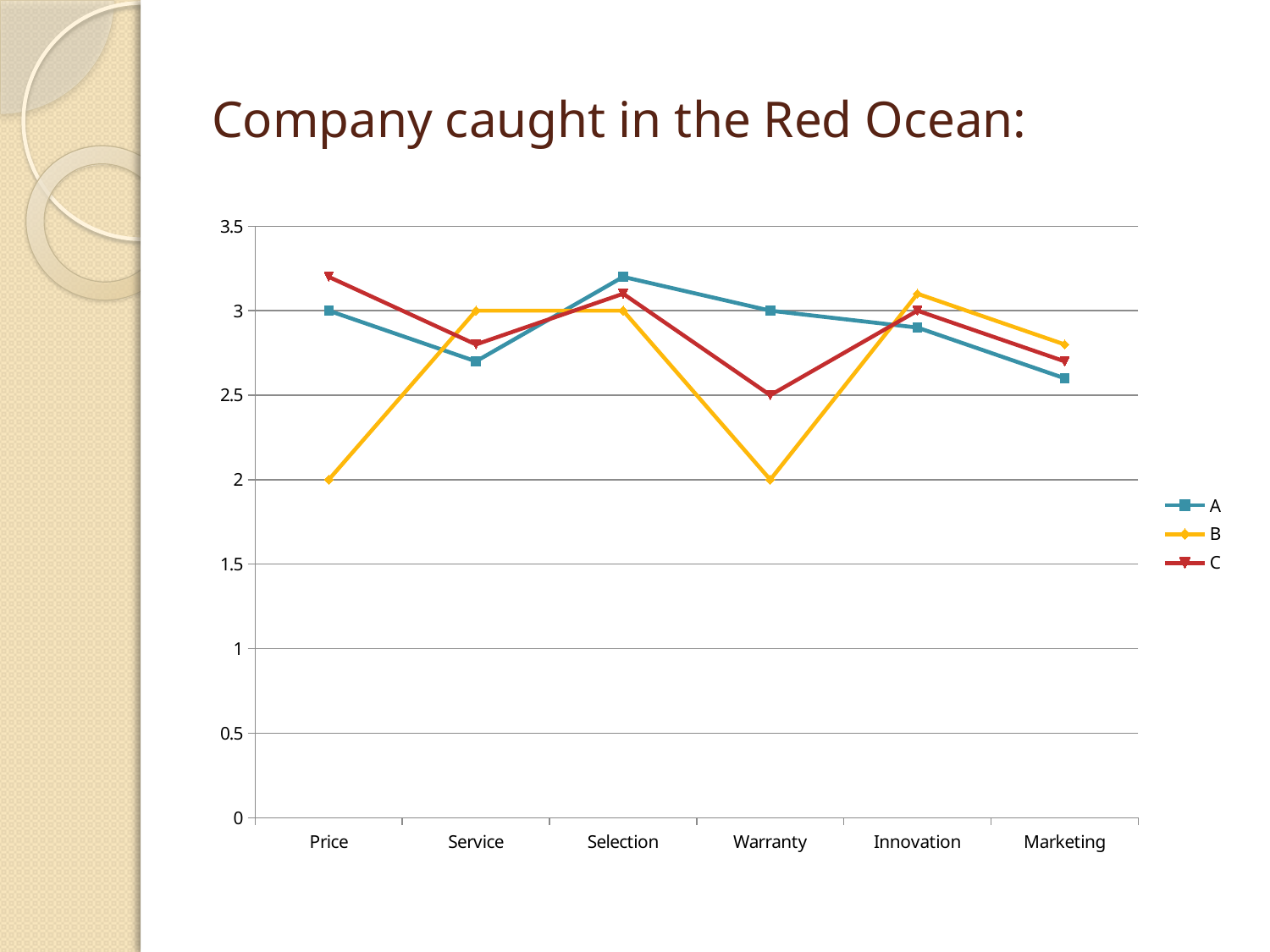
What is the value of series A for Warranty? 3 At Price, which series has the larger value, B or C? C What is the difference between series A and series B at Price? 1 Does series A rise or fall from Selection to Marketing? fall For which category does series A reach its highest value? Selection What is the value of series B for Price? 2 How many categories are shown on the x axis? 6 What is the value of series B for Selection? 3 How many series does the legend list? 3 Is the value of series A for Marketing greater or less than 2.5? greater For which category does series C reach its lowest value? Warranty What type of chart is shown on the slide? line chart